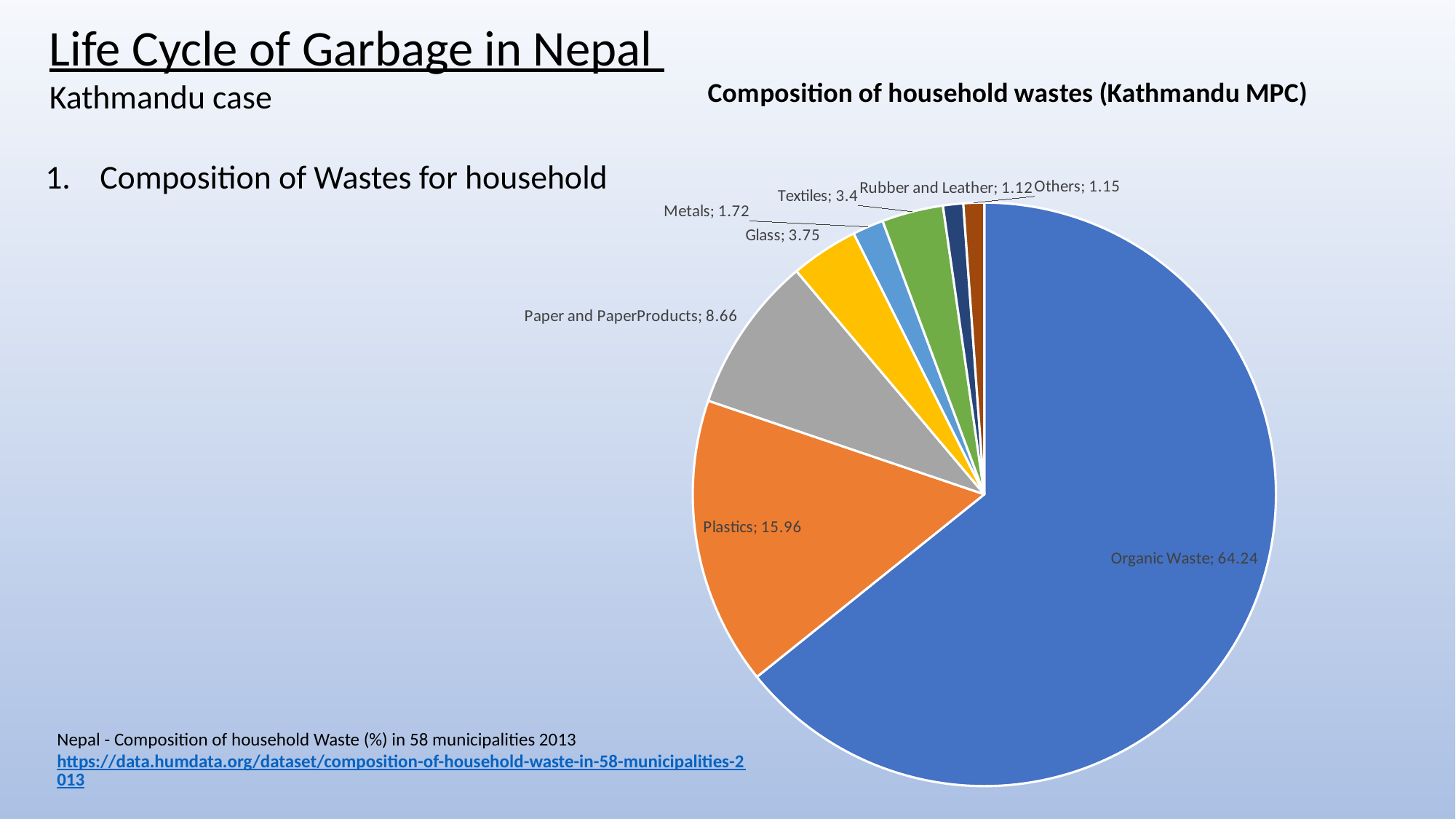
Which is larger, the value for Glass or the value for Textiles? Glass What is the value shown for Organic Waste? 64.24 What type of chart is shown on the slide? pie chart Which category has the largest slice of the pie? Organic Waste Which category has the smallest value in the pie chart? Rubber and Leather How many slices does the pie chart have? 8 What is the value shown for Paper and PaperProducts? 8.66 What is the value shown for Plastics? 15.96 What is the difference between the values for Organic Waste and Plastics? 48.28 What is the title of the chart? Composition of household wastes (Kathmandu MPC) What colour is the Plastics slice? orange What is the value shown for Glass? 3.75